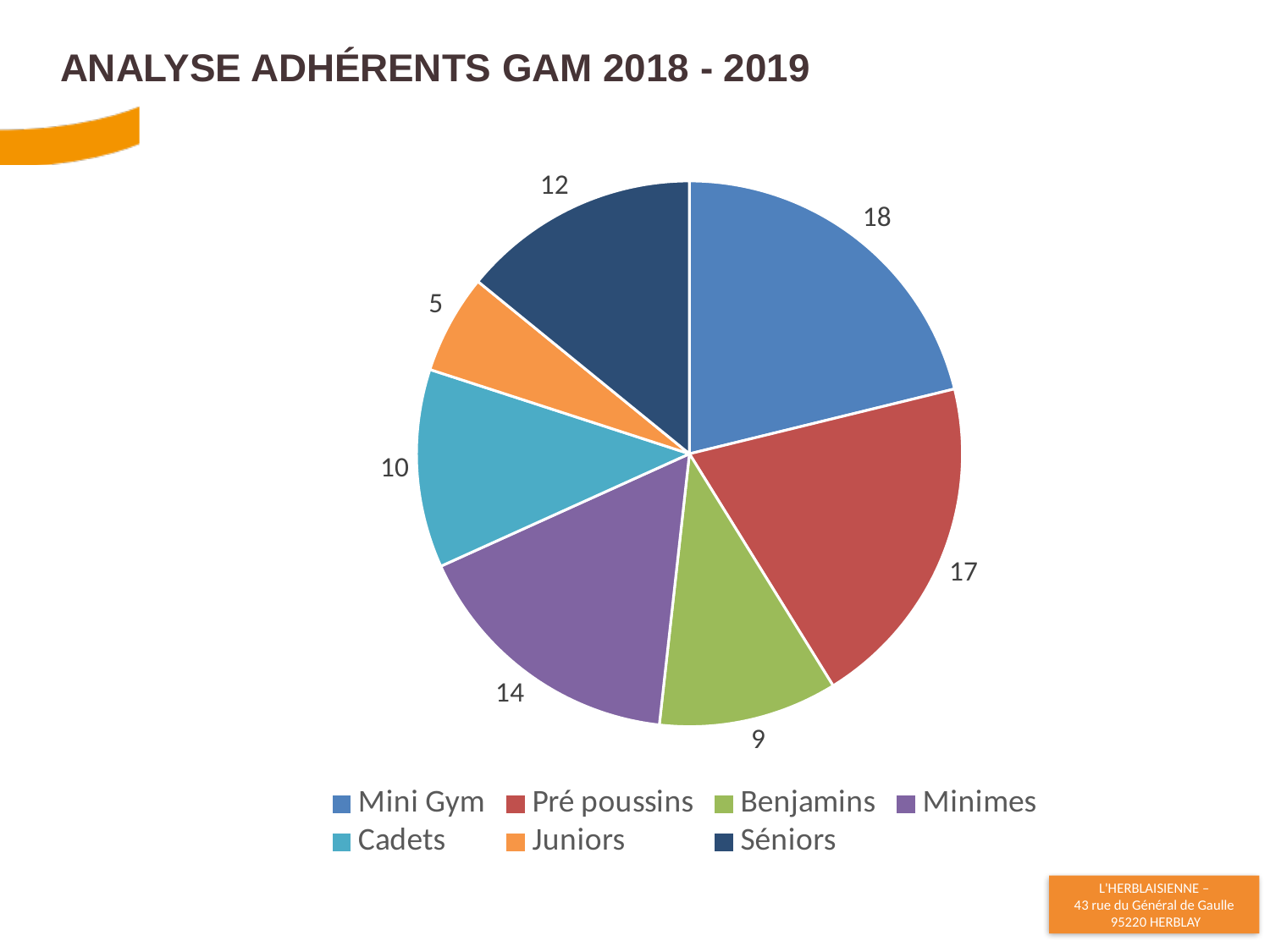
Which is larger, the value for Pré poussins or the value for Minimes? Pré poussins What is the value for Mini Gym in the pie chart? 18 What is the difference between the values for Minimes and Juniors? 9 Which category has the largest slice in the pie chart? Mini Gym What is the title of the slide containing the chart? ANALYSE ADHÉRENTS GAM 2018 - 2019 Which category has the smallest slice in the pie chart? Juniors How many categories does the pie chart show? 7 What kind of chart is shown on the slide? Pie chart What is the value for Séniors in the pie chart? 12 What is the total of all the values shown in the pie chart? 85 What is the value for Cadets in the pie chart? 10 What is the difference between the values for Mini Gym and Benjamins? 9